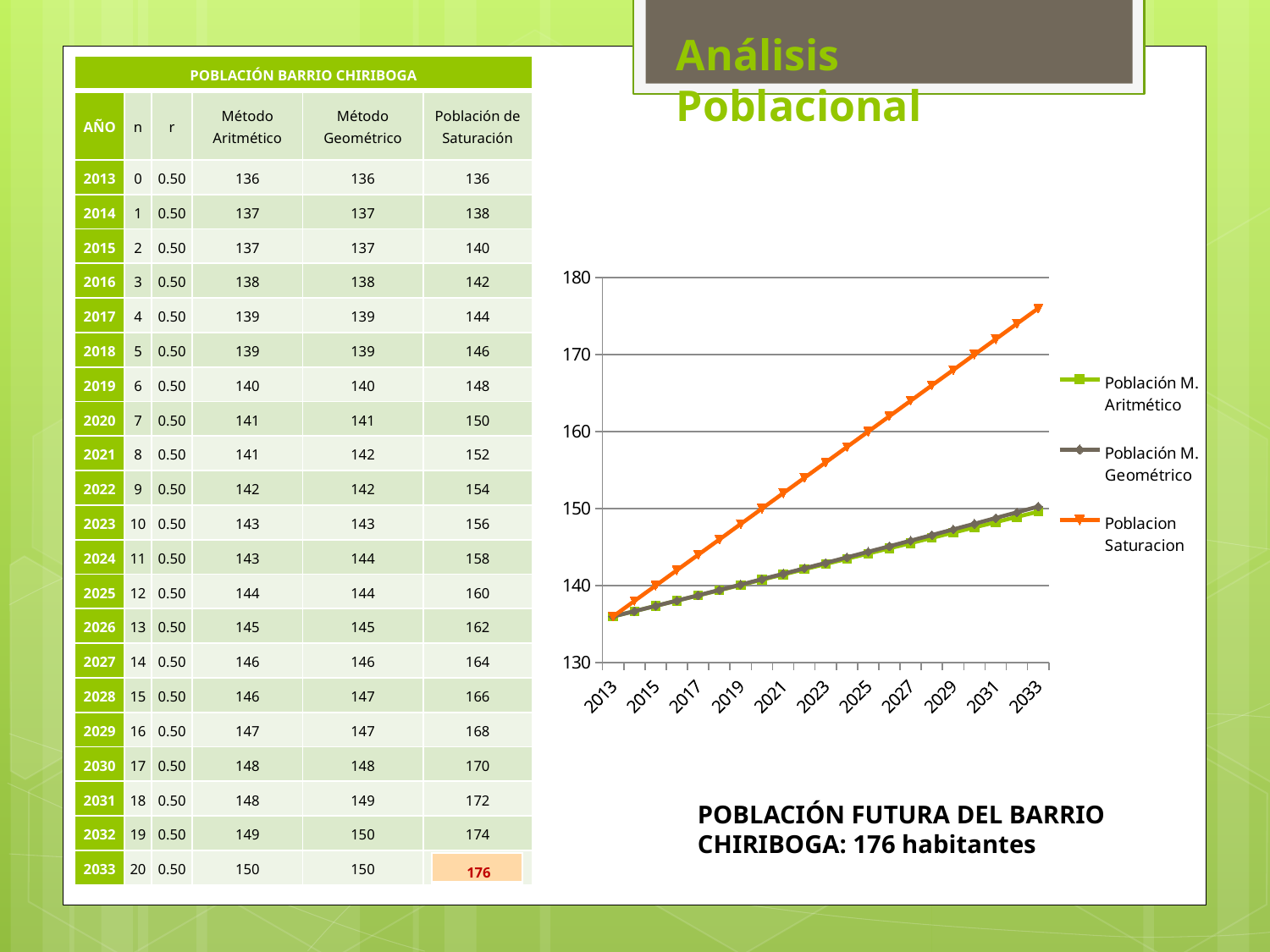
What kind of chart is shown on the slide? line chart Is the value of Poblacion Saturacion in 2023 greater or less than 150? greater Is the value of Población M. Geométrico in 2017 greater or less than 140? less How many years (data points) are plotted along the x axis of the chart? 21 In 2033, which is larger: Poblacion Saturacion or Población M. Aritmético? Poblacion Saturacion What is the value of the Poblacion Saturacion series in 2025? 160 Which series has the highest value in 2033? Poblacion Saturacion How many series does the chart legend list? 3 What is the difference between Poblacion Saturacion and Población M. Aritmético in 2033? 26 What is the value of the Poblacion Saturacion series in 2033? 176 What is the value of the Población M. Aritmético series in 2019? 140 Do the values of the Poblacion Saturacion series rise or fall from 2013 to 2033? rise